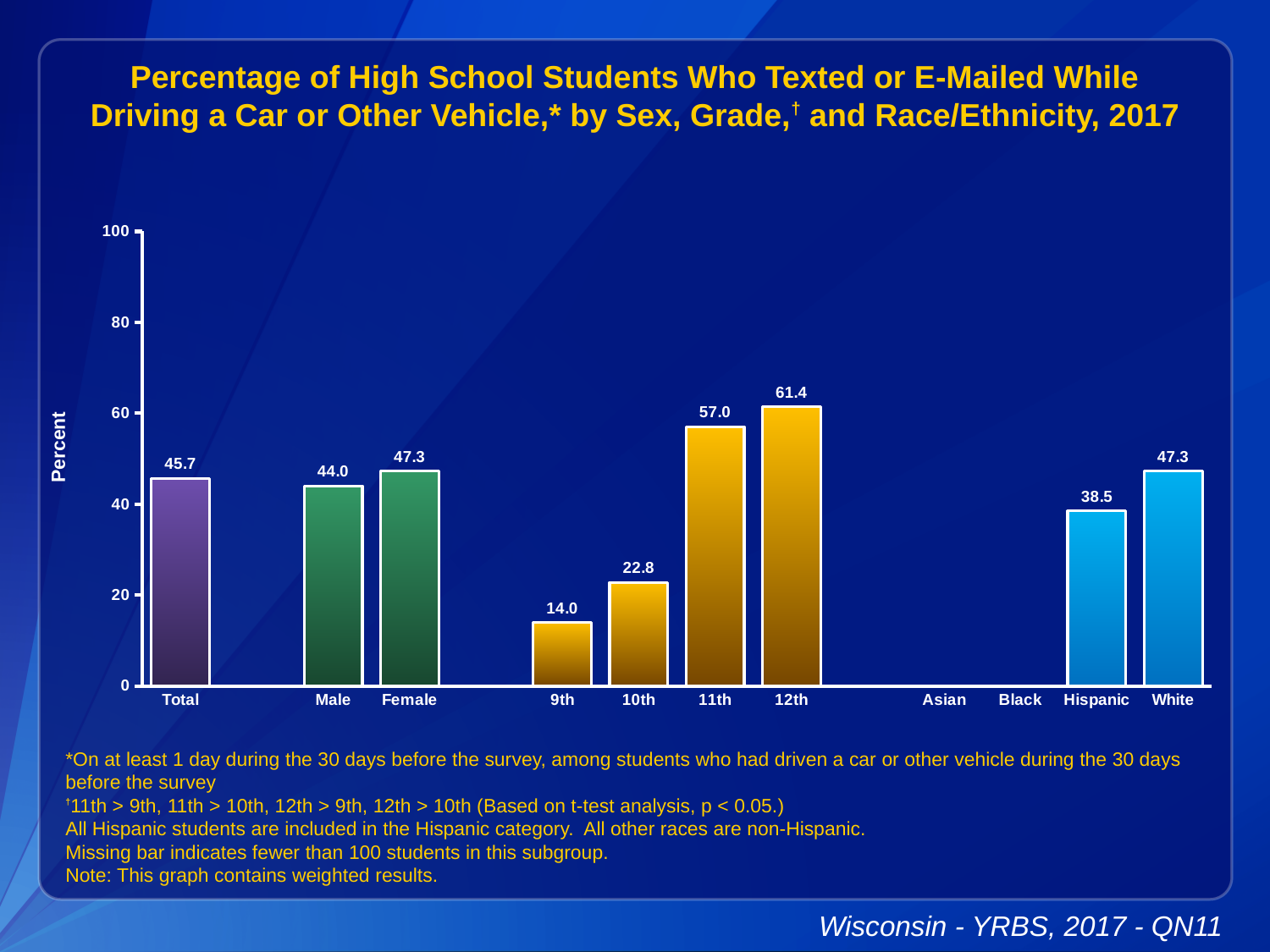
What is the value for Total? 45.7 How many bars are plotted on the chart? 9 What is the difference between the Female and Male values? 3.3 Which category has the highest value? 12th Is the value for 11th grade greater or less than 40? greater Which is larger, the value for White or the value for Hispanic? White Do the values rise or fall from 9th grade to 12th grade? rise What is the difference between the 11th and 10th grade values? 34.2 What is the value for 12th grade? 61.4 Which category has the lowest value? 9th What kind of chart is shown? bar chart What is the value for Hispanic students? 38.5